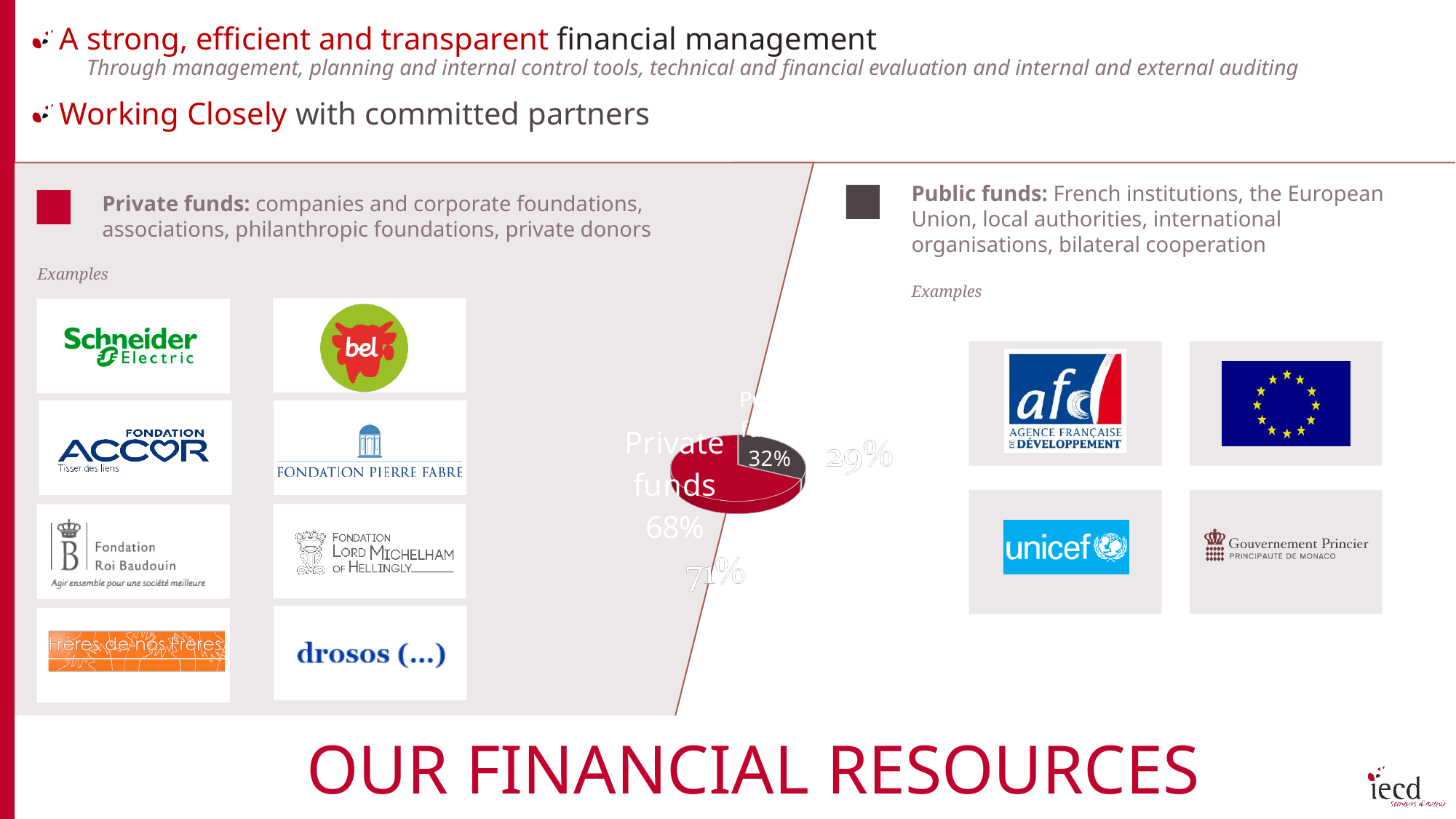
How many slices does the pie chart have? 2 What share of the pie chart is labelled Private funds? 68% What is the difference between the Private funds share (68%) and the 32% slice? 36% Which slice of the pie chart is the largest? Private funds Is the Private funds share greater or less than 50%? greater What kind of chart is shown in the middle of the slide? pie chart Is the Private funds slice larger or smaller than the 32% slice? larger What percentage is printed on the dark grey slice of the pie chart? 32% What colour is the Private funds slice of the pie chart? red